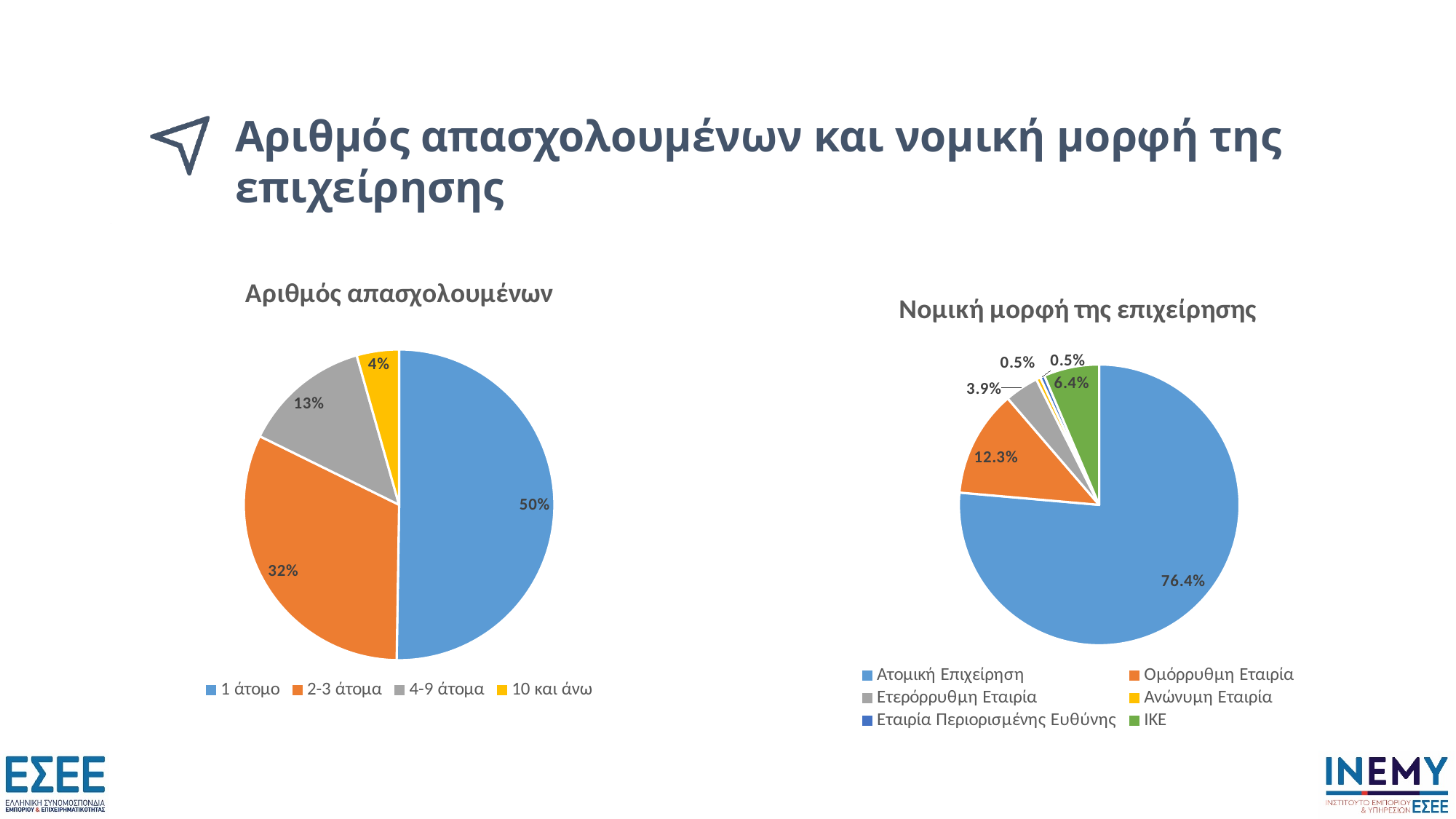
In the 'Αριθμός απασχολουμένων' chart, what share is shown for '1 άτομο'? 50% How many categories does the 'Αριθμός απασχολουμένων' chart show? 4 In the 'Νομική μορφή της επιχείρησης' chart, which is larger: 'Ομόρρυθμη Εταιρία' or 'Ετερόρρυθμη Εταιρία'? Ομόρρυθμη Εταιρία In the 'Αριθμός απασχολουμένων' chart, what share is shown for '4-9 άτομα'? 13% In the 'Αριθμός απασχολουμένων' chart, which category has the smallest slice? 10 και άνω How many entries does the legend of the 'Νομική μορφή της επιχείρησης' chart list? 6 In the 'Νομική μορφή της επιχείρησης' chart, which category has the largest slice? Ατομική Επιχείρηση In the 'Αριθμός απασχολουμένων' chart, what is the difference between the shares for '2-3 άτομα' and '4-9 άτομα'? 19% What type of chart is 'Νομική μορφή της επιχείρησης'? Pie chart In the 'Νομική μορφή της επιχείρησης' chart, what share is shown for 'ΙΚΕ'? 6.4% In the 'Νομική μορφή της επιχείρησης' chart, what share is shown for 'Ατομική Επιχείρηση'? 76.4% In the 'Νομική μορφή της επιχείρησης' chart, what colour is the 'ΙΚΕ' slice? Green